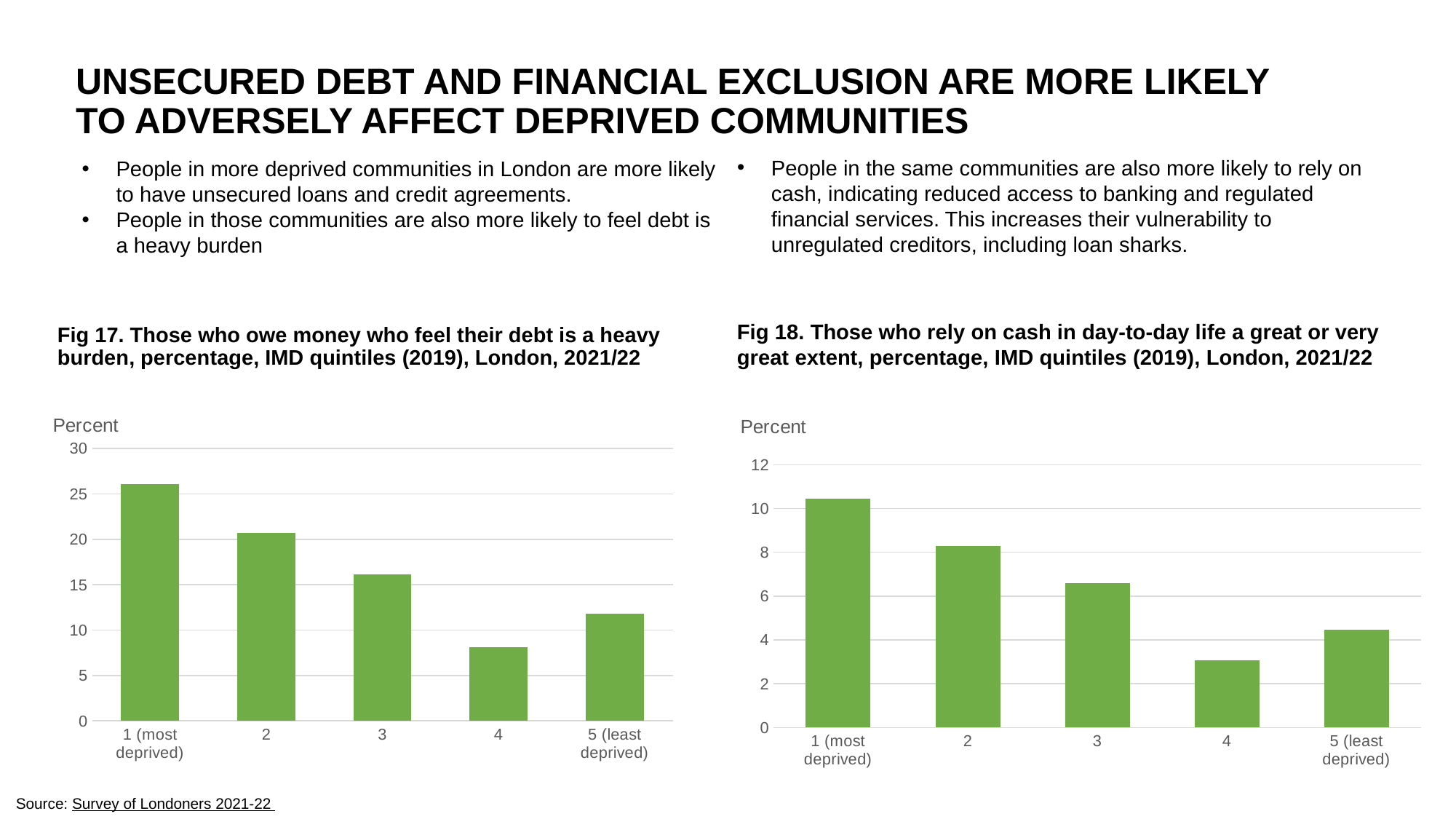
In Fig 17, which quintile has the highest percentage feeling their debt is a heavy burden? 1 (most deprived) In Fig 17, is the value for quintile 4 greater or less than 10? less In Fig 18, is the value for quintile 1 (most deprived) greater or less than 10? greater In Fig 18, which quintile has the lowest percentage? 4 In Fig 18, what is the label on the vertical axis? Percent In Fig 17, is the value for quintile 1 (most deprived) greater or less than 25? greater In Fig 17, what kind of chart is used? bar chart In Fig 18, which quintile has the highest percentage relying on cash to a great or very great extent? 1 (most deprived) In Fig 17, which quintile has the lowest percentage? 4 In Fig 17, which is larger: the value for quintile 4 or quintile 5 (least deprived)? 5 (least deprived) In Fig 17, how many IMD quintile categories are shown on the x axis? 5 In Fig 18, which is larger: the value for quintile 2 or quintile 3? 2